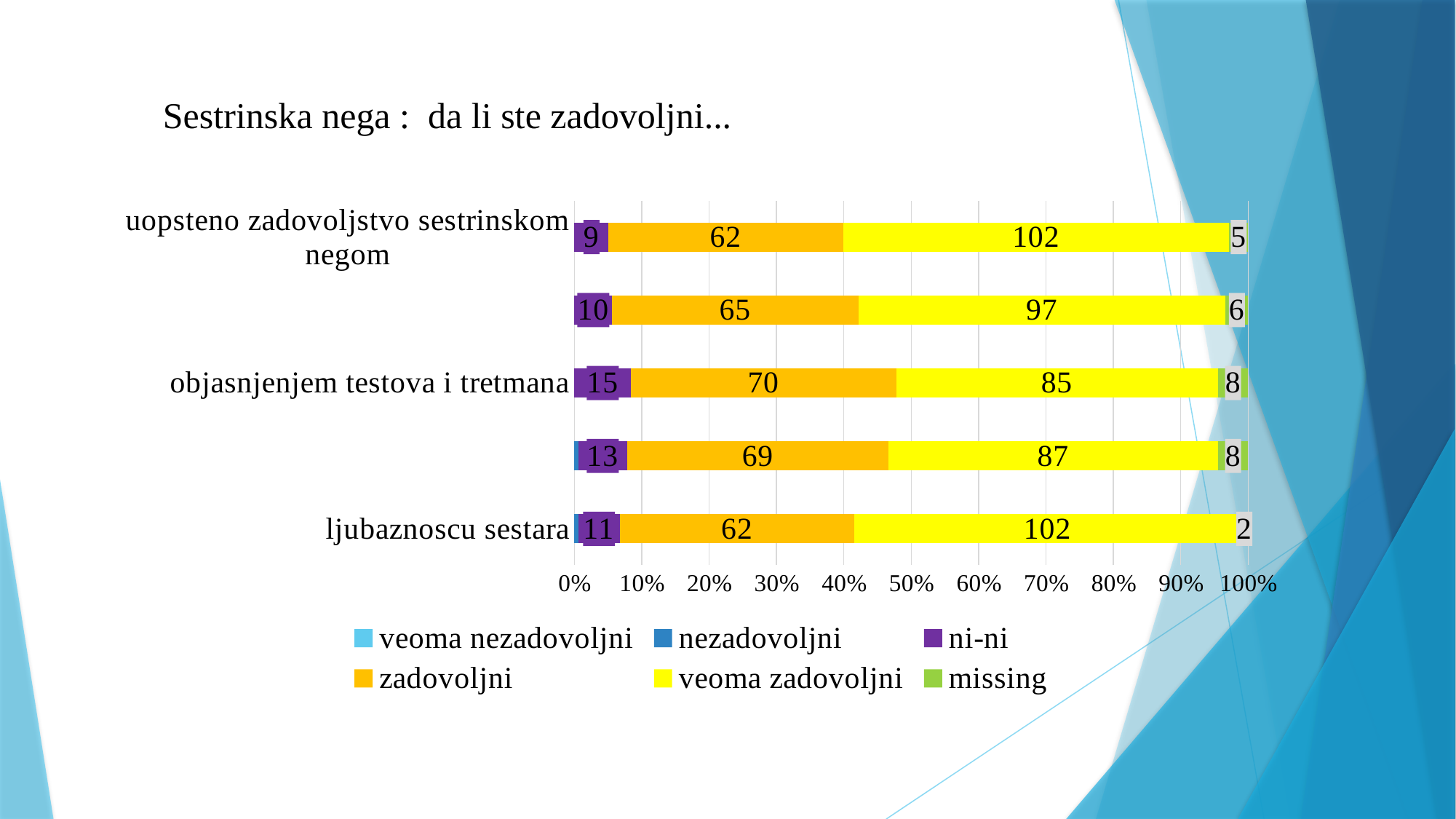
What is the value of 'missing' for 'ljubaznoscu sestara'? 2 What is the value of 'veoma zadovoljni' for 'uopsteno zadovoljstvo sestrinskom negom'? 102 What is the value of 'ni-ni' for 'ljubaznoscu sestara'? 11 What is the difference between the 'veoma zadovoljni' values for 'ljubaznoscu sestara' and 'objasnjenjem testova i tretmana'? 17 What is the title of the slide? Sestrinska nega : da li ste zadovoljni... Which has a larger 'ni-ni' value: 'objasnjenjem testova i tretmana' or 'uopsteno zadovoljstvo sestrinskom negom'? objasnjenjem testova i tretmana What kind of chart is shown on the slide? stacked bar chart What is the value of 'zadovoljni' for 'objasnjenjem testova i tretmana'? 70 What is the value of 'missing' for 'objasnjenjem testova i tretmana'? 8 Which colour represents the 'veoma zadovoljni' series in the legend? yellow How many series does the legend list? 6 How many bars are plotted in the chart? 5